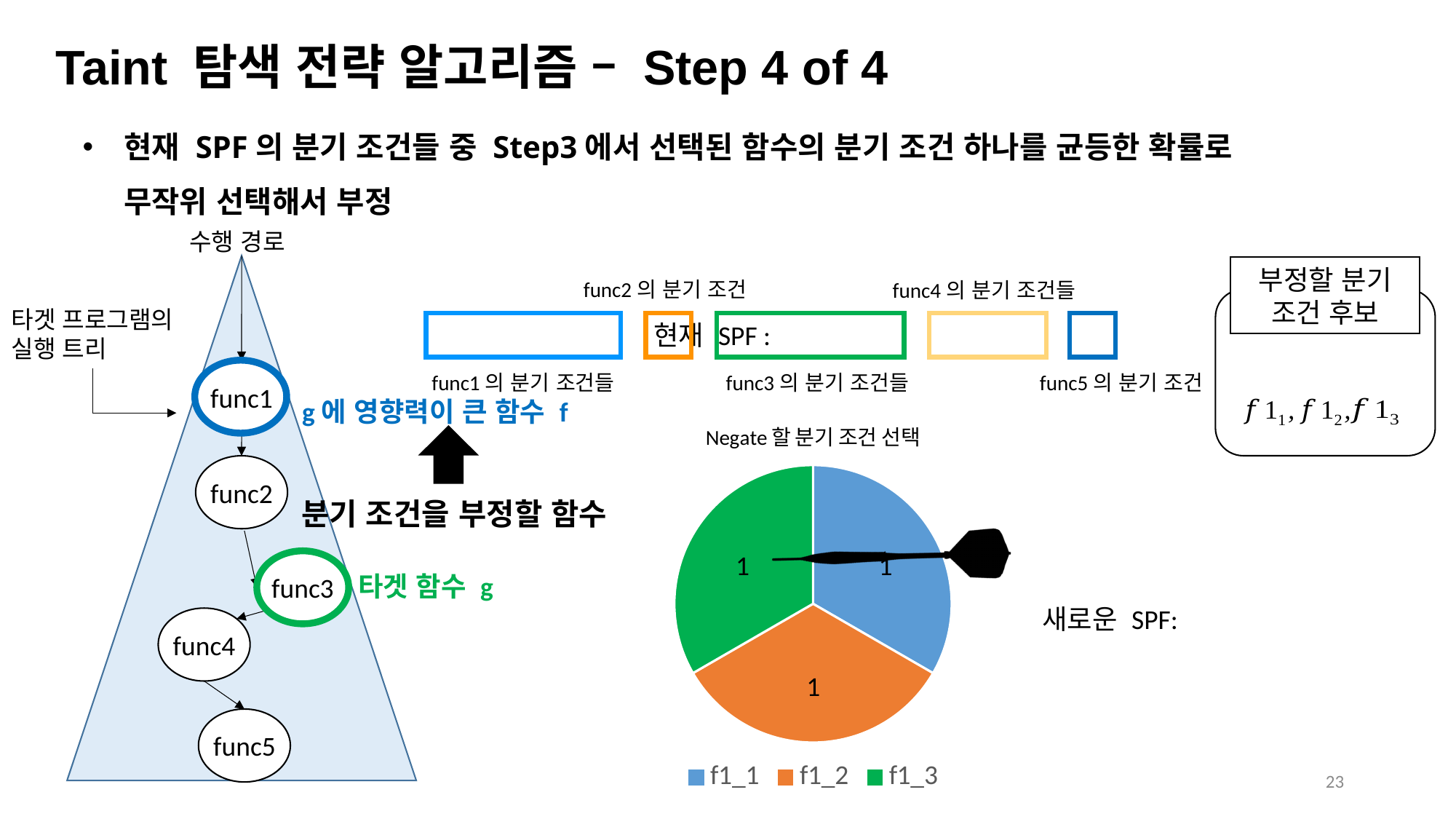
What is the title of the pie chart? Negate 할 분기 조건 선택 How many slices does the pie chart have? 3 What is the total of all the slice values in the pie chart? 3 What is the value shown for the f1_1 slice of the pie chart? 1 What is the difference between the values of the f1_1 and f1_3 slices? 0 What is the value shown for the f1_3 slice of the pie chart? 1 Which colour represents f1_3 in the pie chart? green What is the value shown for the f1_2 slice of the pie chart? 1 What share of the pie does the f1_2 slice represent? 1/3 How many entries does the pie chart's legend list? 3 What kind of chart is shown on the slide? pie chart